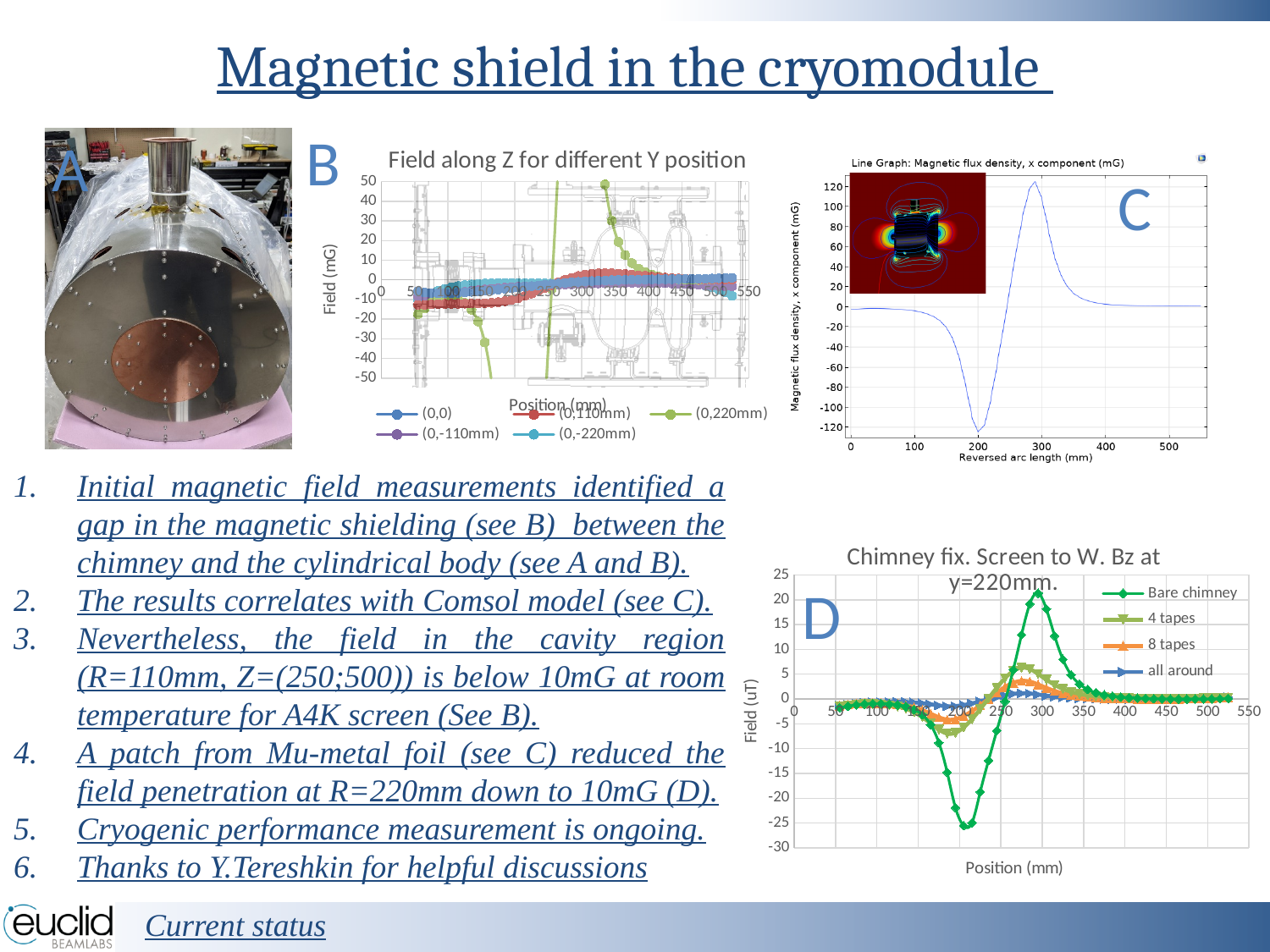
In the chart titled 'Chimney fix. Screen to W. Bz at y=220mm.', which series reaches the lowest value? Bare chimney In the chart titled 'Chimney fix. Screen to W. Bz at y=220mm.', is the minimum value of the Bare chimney series greater or less than -20? less In the chart titled 'Field along Z for different Y position', what is the label of the y axis? Field (mG) In the chart titled 'Chimney fix. Screen to W. Bz at y=220mm.', which series reaches the highest peak value? Bare chimney In the chart titled 'Chimney fix. Screen to W. Bz at y=220mm.', is the peak value of the 8 tapes series greater or less than 10? less In the chart titled 'Field along Z for different Y position', which series reaches the highest value on the chart? (0,220mm) In the chart titled 'Chimney fix. Screen to W. Bz at y=220mm.', how many series does the legend list? 4 In the chart labelled C (Line Graph: Magnetic flux density, x component), what is the label of the x axis? Reversed arc length (mm) What kind of chart is the chart titled 'Field along Z for different Y position'? line chart In the chart labelled C (Line Graph: Magnetic flux density, x component), is the minimum value of the curve greater or less than -100? less In the chart titled 'Field along Z for different Y position', how many series does the legend list? 5